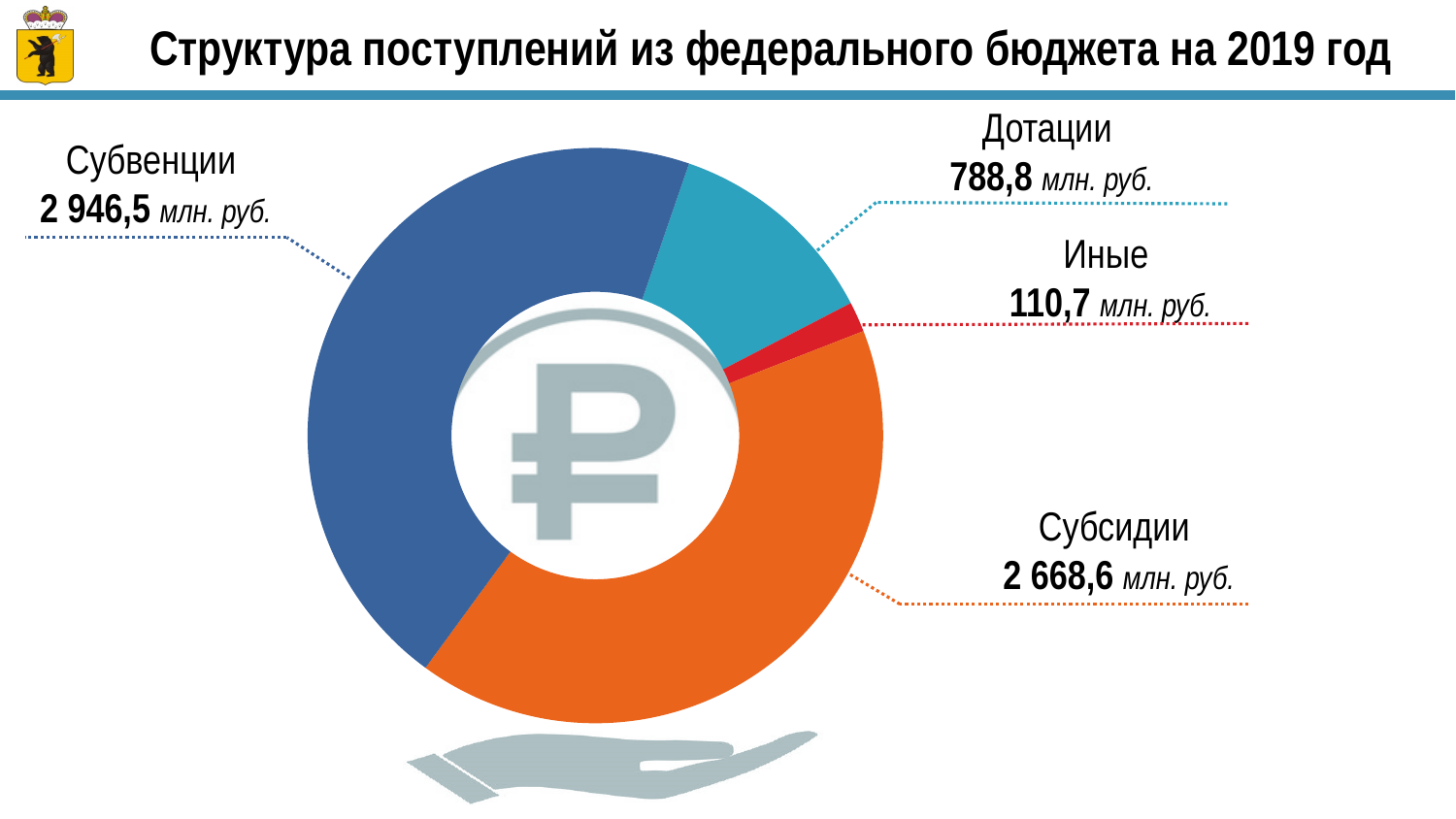
What is the value for Субвенции? 2 946,5 млн. руб. What is the value for Дотации? 788,8 млн. руб. What is the value for Субсидии? 2 668,6 млн. руб. How many categories does the chart show? 4 Which category has the lowest value? Иные Which is larger, Дотации or Иные? Дотации What kind of chart is shown on the slide? Doughnut (ring) chart What is the title of the slide? Структура поступлений из федерального бюджета на 2019 год Which category has the highest value? Субвенции What is the difference between Дотации and Иные? 678,1 млн. руб. What is the difference between Субвенции and Субсидии? 277,9 млн. руб. What is the value for Иные? 110,7 млн. руб.